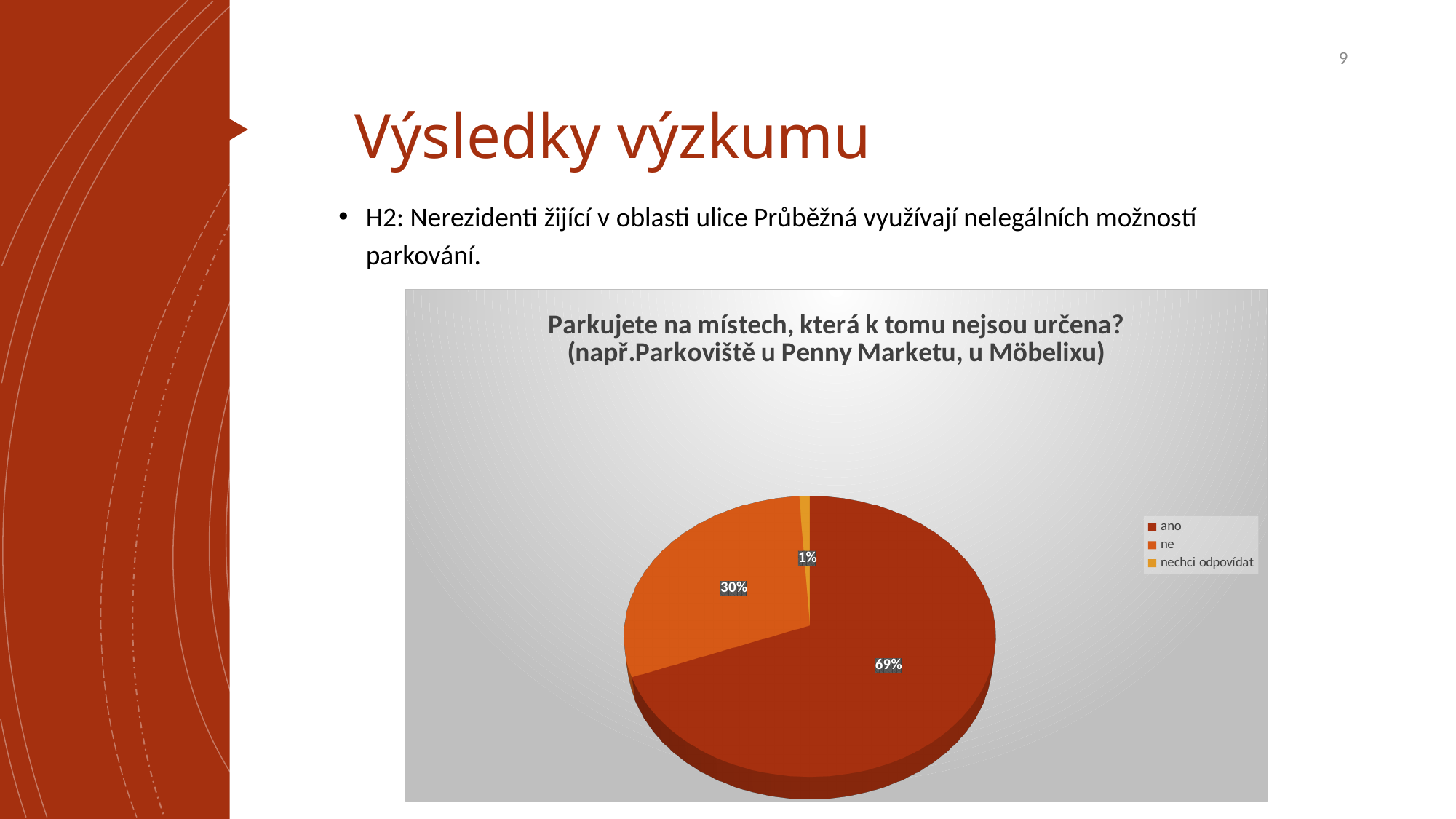
How many entries does the legend list? 3 Which legend entry is shown in the yellow-orange colour? nechci odpovídat Which category has the largest slice of the pie? ano How many categories does the pie chart have? 3 What is the first line of the chart title? Parkujete na místech, která k tomu nejsou určena? What share of the pie does "nechci odpovídat" have? 1% What share of the pie does "ano" have? 69% What is the difference in percentage points between the "ano" and "ne" slices? 39 Which category has the smallest slice of the pie? nechci odpovídat What share of the pie does "ne" have? 30% What kind of chart is shown on the slide? pie chart Which is larger, the "ne" slice or the "nechci odpovídat" slice? ne